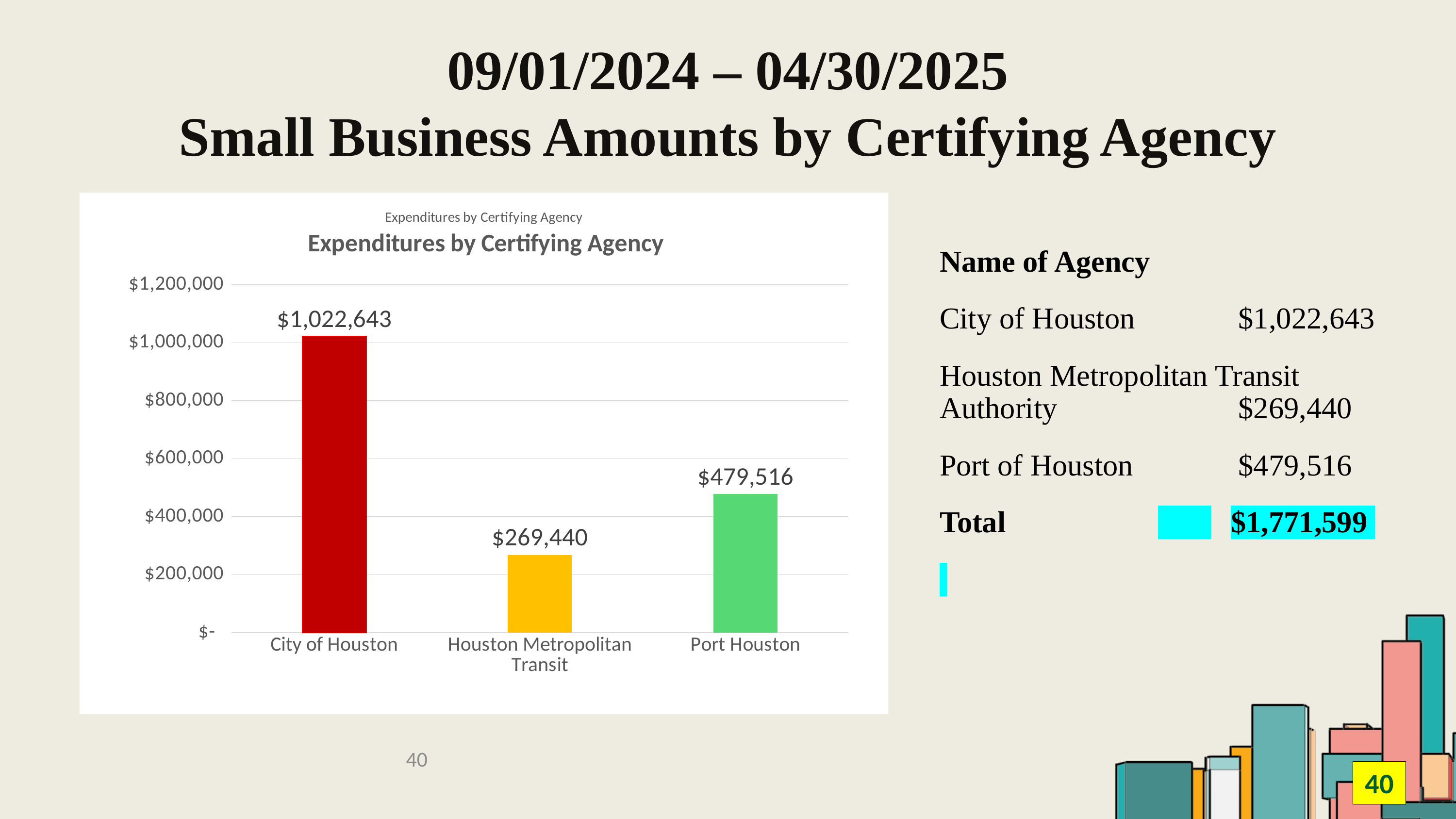
Is the value for Port Houston greater or less than $400,000? greater What is the title of the chart? Expenditures by Certifying Agency What kind of chart is shown? bar chart Which is larger, the value for Port Houston or the value for Houston Metropolitan Transit? Port Houston What is the difference between the values for Port Houston and Houston Metropolitan Transit? $210,076 What is the value for Port Houston? $479,516 What is the difference between the values for City of Houston and Port Houston? $543,127 Which category has the highest value? City of Houston What is the value for Houston Metropolitan Transit? $269,440 Which category has the lowest value? Houston Metropolitan Transit What is the value for City of Houston? $1,022,643 How many categories are shown on the chart? 3